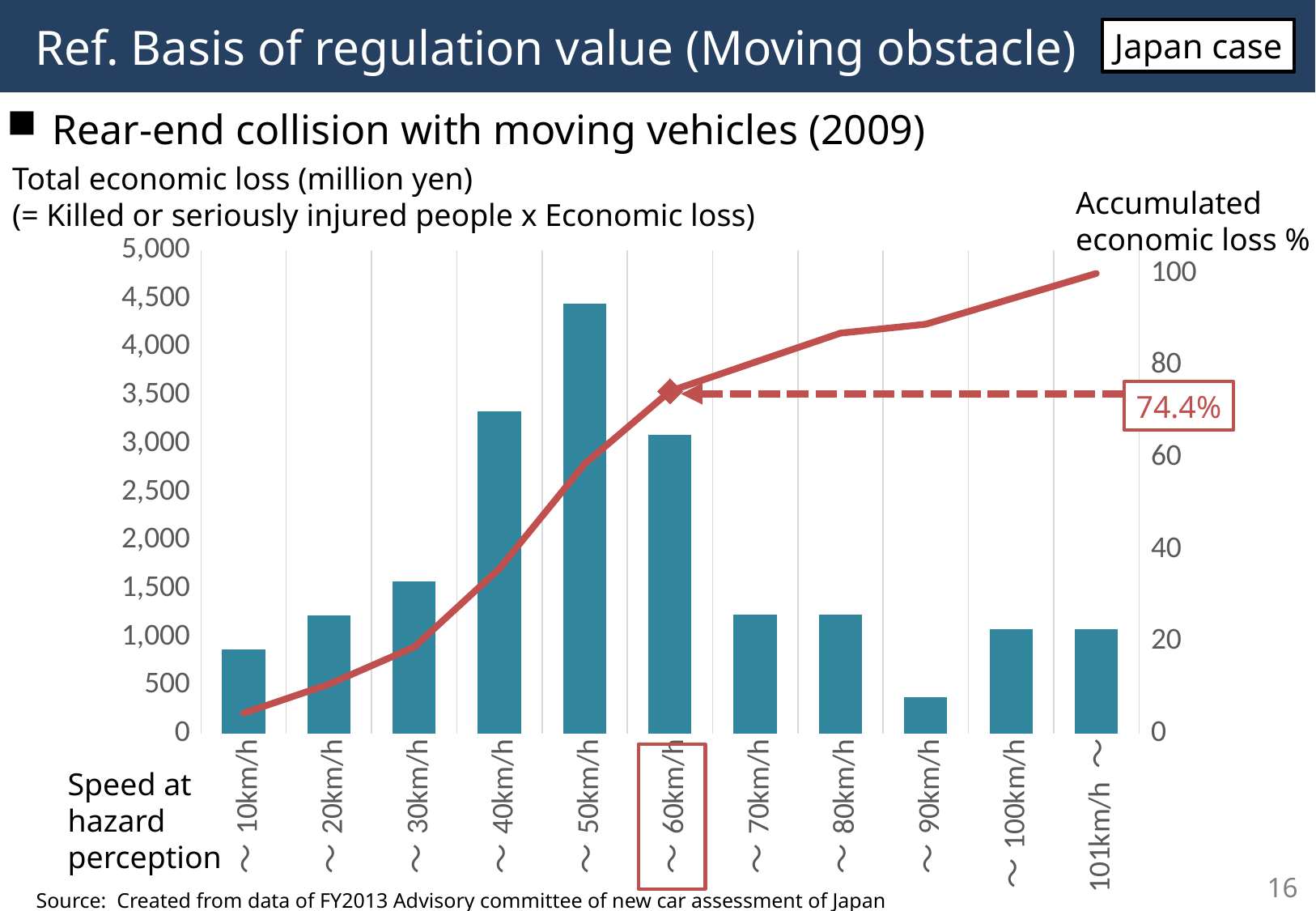
Is the total economic loss for ~40km/h greater or less than 3,000? greater Which has the larger total economic loss, ~40km/h or ~60km/h? ~40km/h How many speed categories are shown on the x axis? 11 What unit is given for the total economic loss on the left axis? million yen Does the accumulated economic loss line rise or fall as speed increases along the x axis? rises What kind of chart is used to show total economic loss by speed? bar chart (with a line overlay) Is the total economic loss for ~50km/h greater or less than 4,000? greater Is the total economic loss for ~90km/h greater or less than 500? less Which speed category has the highest total economic loss bar? ~50km/h What accumulated economic loss percentage is labelled at the ~60km/h point on the line? 74.4% Which speed category has the lowest total economic loss bar? ~90km/h